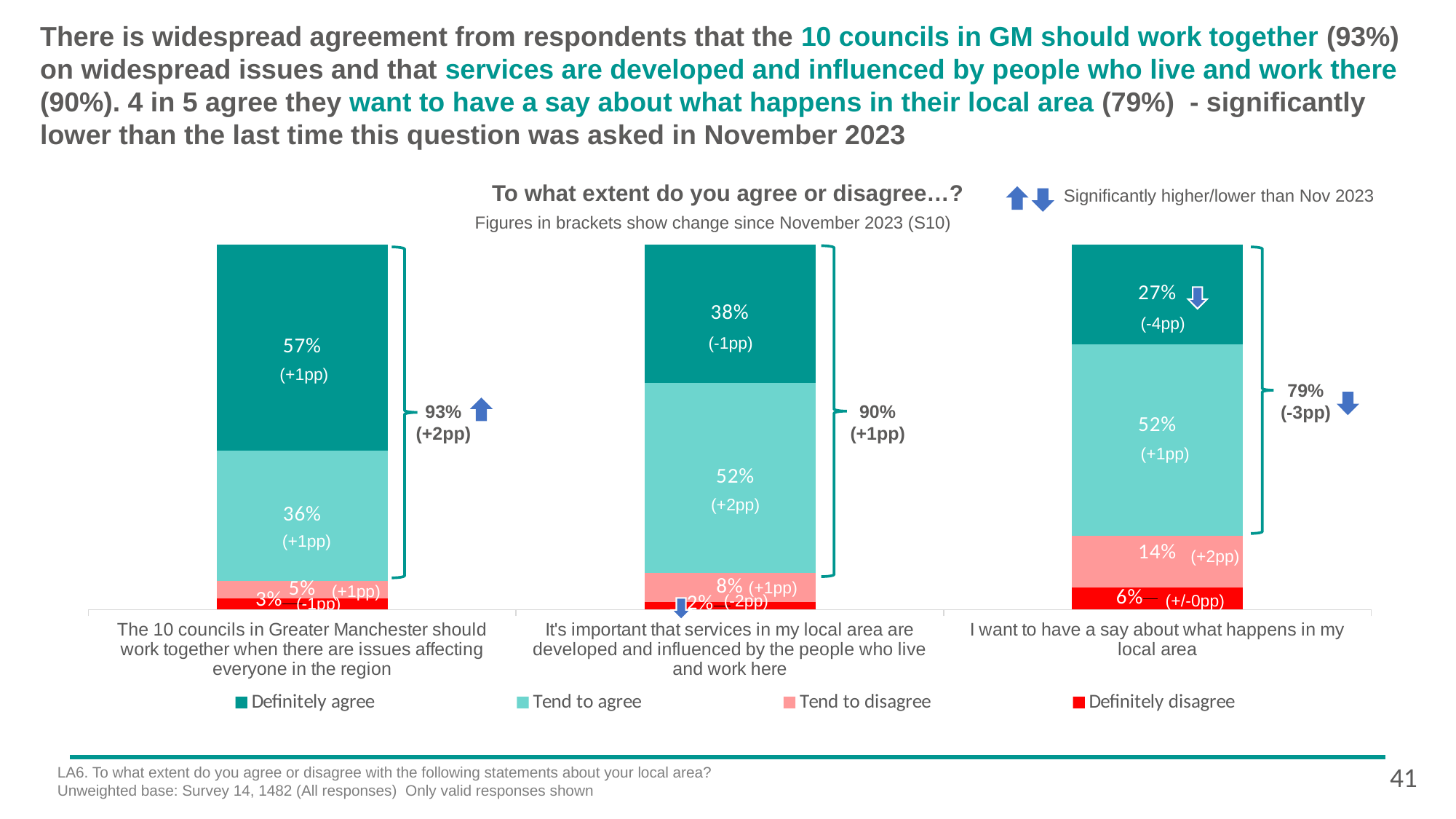
How many statements are shown on the chart? 3 Which statement has the lowest 'Definitely disagree' percentage? It's important that services in my local area are developed and influenced by the people who live and work here What is the change since November 2023 shown for the 93% agreement figure? +2pp How many series does the legend list? 4 What kind of chart is shown on the slide? Stacked bar chart Which statement has the highest 'Definitely agree' percentage? The 10 councils in Greater Manchester should work together when there are issues affecting everyone in the region What percentage tend to disagree with the statement 'I want to have a say about what happens in my local area'? 14% What percentage of respondents definitely agree that the 10 councils in Greater Manchester should work together when there are issues affecting everyone in the region? 57% What percentage tend to agree that it's important that services in my local area are developed and influenced by the people who live and work here? 52% Which is larger: the 'Tend to disagree' share for the having a say statement or for the services developed locally statement? I want to have a say about what happens in my local area What is the difference in 'Definitely agree' percentage between the councils working together statement and the having a say statement? 30 percentage points What is the combined agreement figure shown for 'I want to have a say about what happens in my local area'? 79%